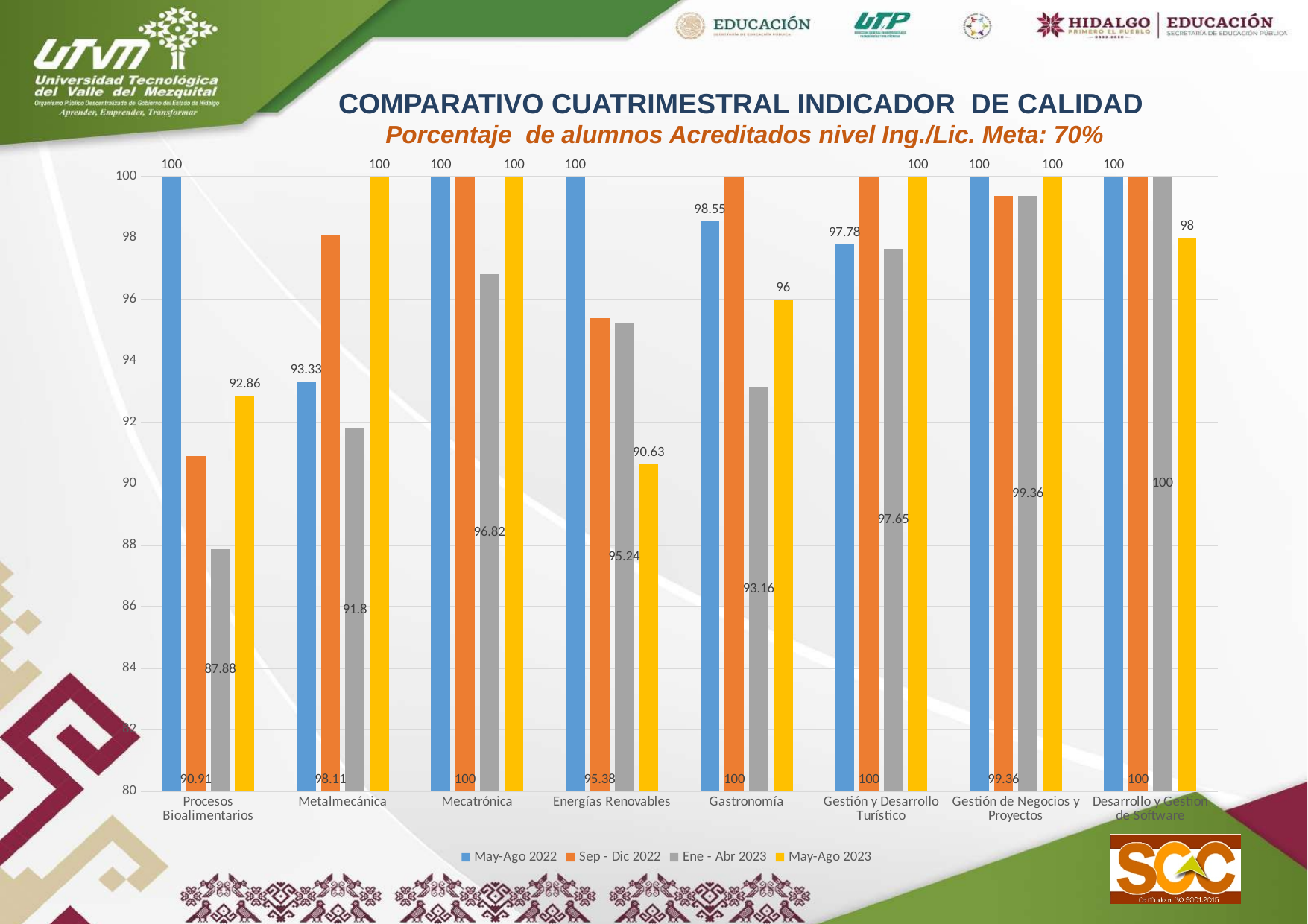
What target (Meta) is stated in the chart subtitle? 70% For Metalmecánica, which is larger: the May-Ago 2022 value or the Sep - Dic 2022 value? Sep - Dic 2022 What is the May-Ago 2023 value for Energías Renovables? 90.63 Which category has the lowest Ene - Abr 2023 value? Procesos Bioalimentarios How many categories (programs) are shown along the x axis? 8 How many series does the legend list? 4 What is the Ene - Abr 2023 value for Metalmecánica? 91.8 For Procesos Bioalimentarios, what is the difference between the May-Ago 2023 value and the Ene - Abr 2023 value? 4.98 What is the May-Ago 2022 value for Gastronomía? 98.55 What is the May-Ago 2023 value for Procesos Bioalimentarios? 92.86 What kind of chart is shown on the slide? Bar chart Is the Ene - Abr 2023 value for Procesos Bioalimentarios greater or less than 90? less